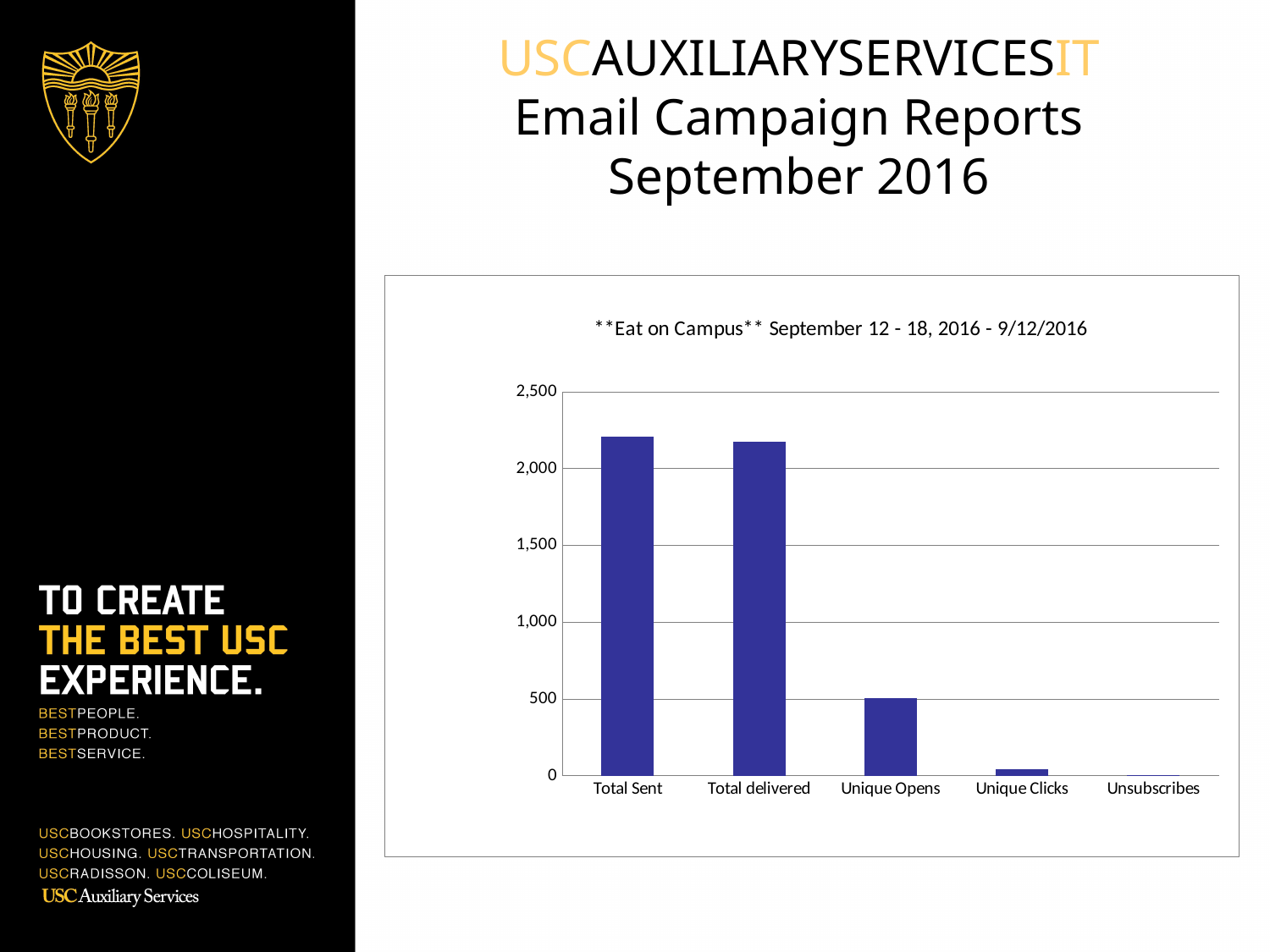
Is the value for Unique Opens greater or less than 1,000? less Is the value for Total Sent greater or less than 2,000? greater Which is larger, the value for Unique Opens or the value for Unique Clicks? Unique Opens Is the value for Total Sent greater or less than 2,500? less What is the title of the chart? **Eat on Campus** September 12 - 18, 2016 - 9/12/2016 Which category has the lowest value in the chart? Unsubscribes Which is larger, the value for Total Sent or the value for Unique Opens? Total Sent Do the values rise or fall moving from left to right along the x axis? fall How many categories are shown on the x axis of the chart? 5 What kind of chart is shown on the slide? bar chart